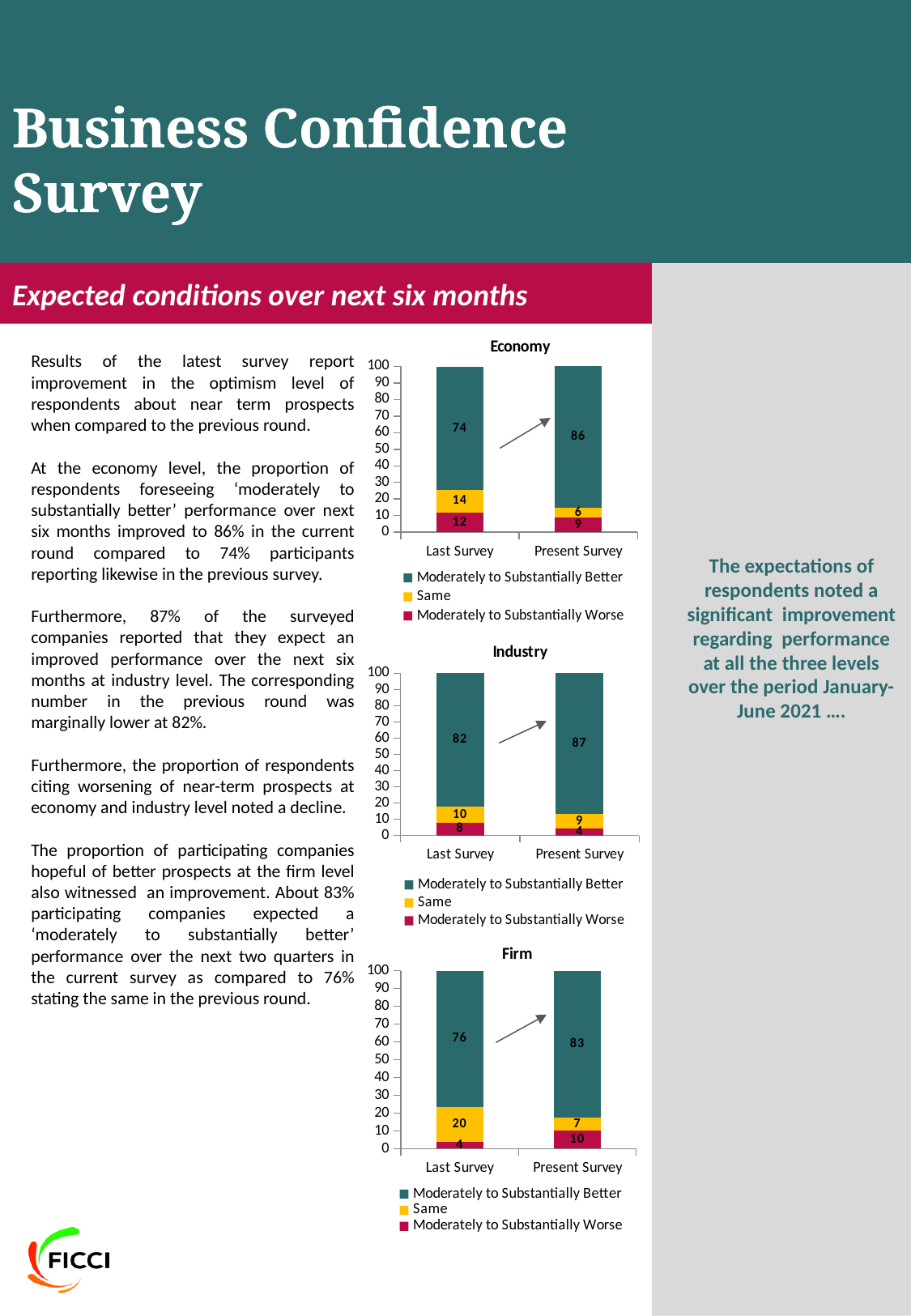
In the Firm chart, which survey has the larger 'Moderately to Substantially Worse' value, Last Survey or Present Survey? Present Survey How many categories are shown on the x axis of the Firm chart? 2 In the Economy chart, what is the total of the stacked bar for the Last Survey? 100 How many series does the legend of the Industry chart list? 3 In the Firm chart, what is the value for 'Same' in the Last Survey? 20 In the Firm chart, what is the total of the stacked bar for the Present Survey? 100 In the Economy chart, what is the value for 'Moderately to Substantially Better' in the Present Survey? 86 In the Industry chart, what is the value for 'Moderately to Substantially Worse' in the Present Survey? 4 In the Economy chart, does the 'Moderately to Substantially Better' value rise or fall from the Last Survey to the Present Survey? Rise What kind of chart is the Economy chart? Stacked bar chart In the Industry chart, what is the difference between the 'Moderately to Substantially Better' values for the Present Survey and the Last Survey? 5 In the Economy chart, what is the value for 'Same' in the Last Survey? 14